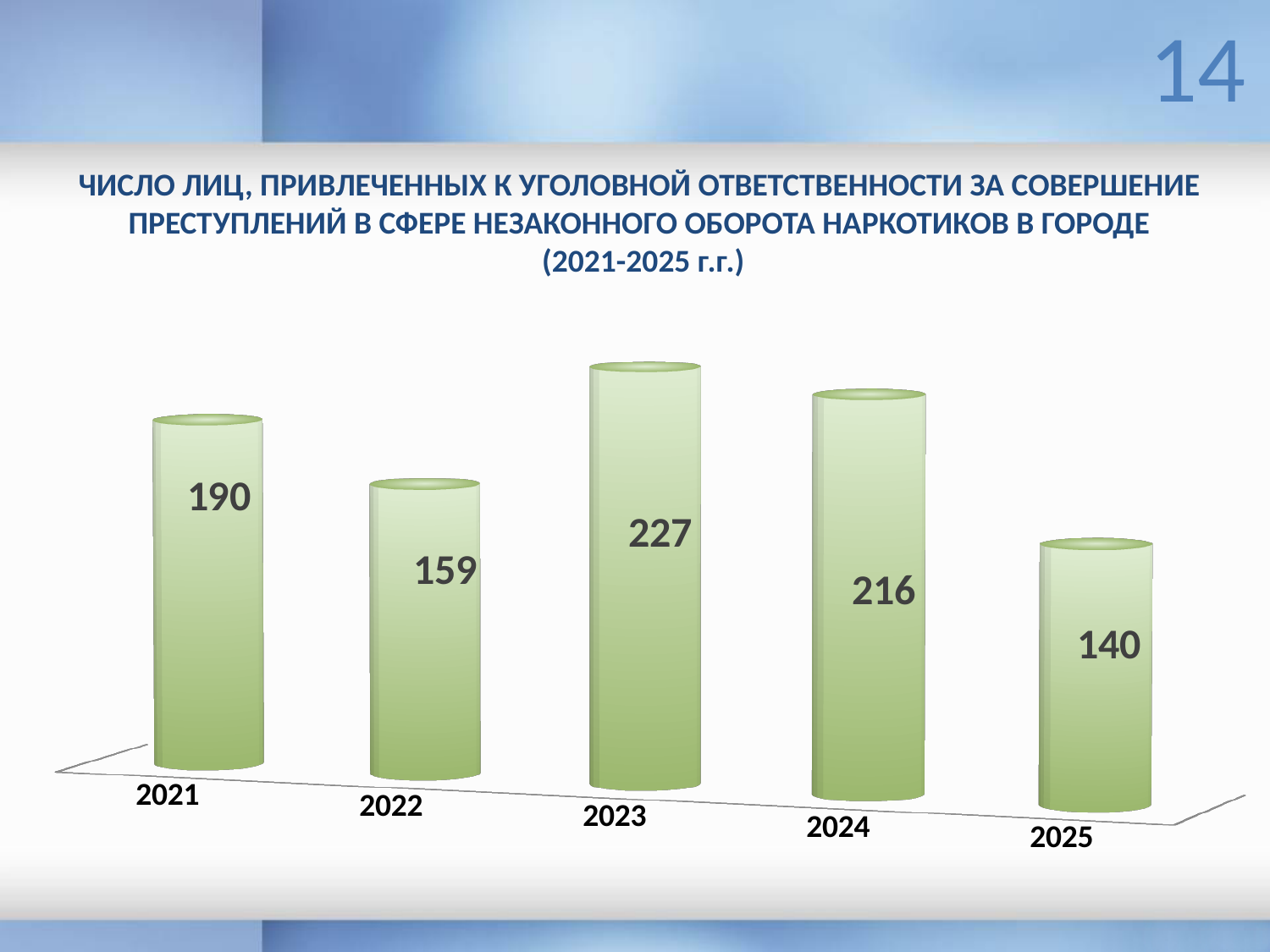
How many years are shown on the chart? 5 What kind of chart is shown on the slide? bar chart Which year has the highest value? 2023 What is the difference between the values for 2021 and 2025? 50 What is the value for 2021? 190 Which is larger, the value for 2022 or the value for 2024? 2024 Which year has the lowest value? 2025 What is the value for 2023? 227 What period does the chart title say the data covers? 2021-2025 г.г. What is the value for 2025? 140 What is the difference between the values for 2023 and 2024? 11 Do the values rise or fall from 2023 to 2025? fall